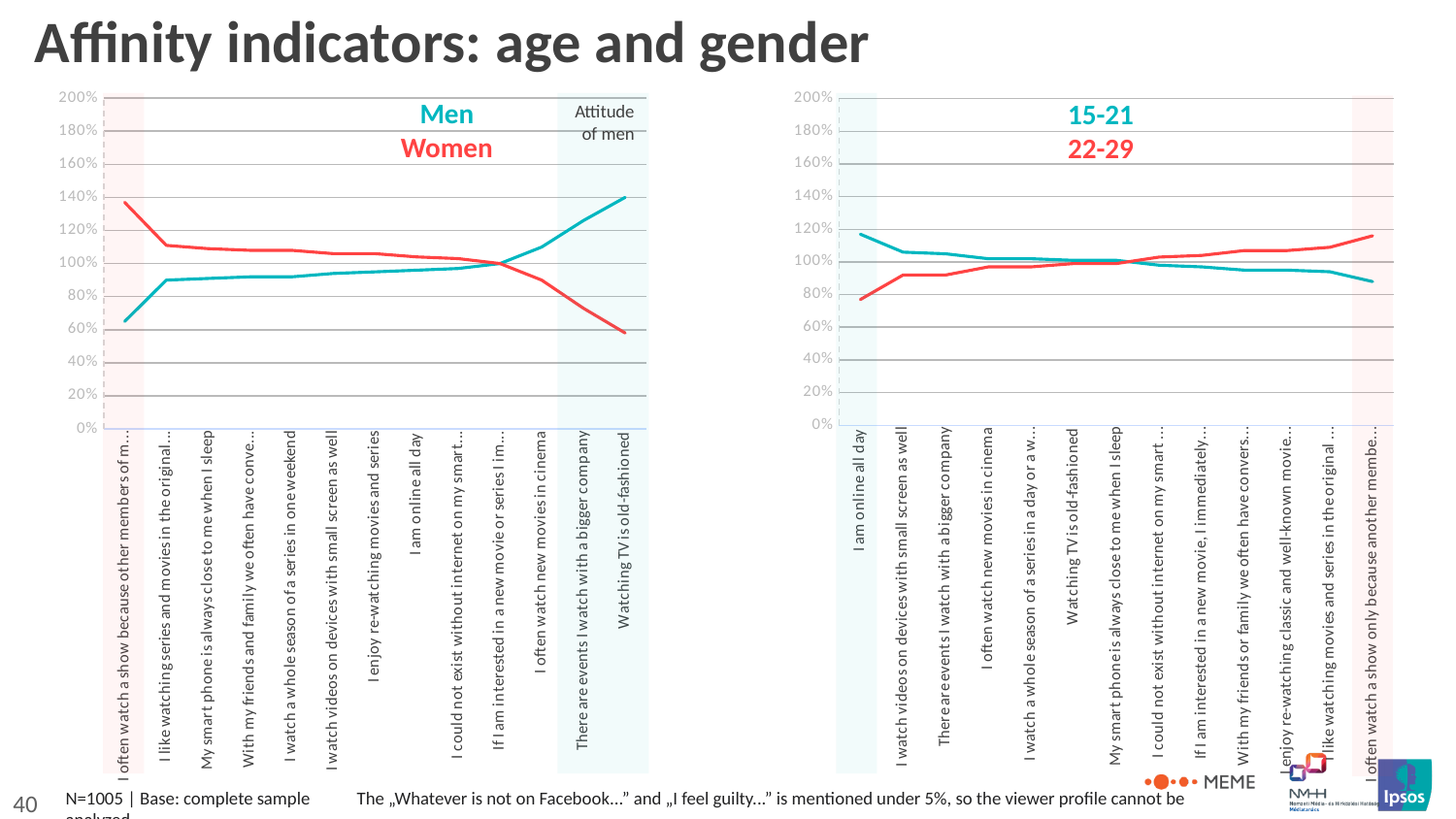
In the right chart, for "I often watch a show only because another membe...", which series is higher, 15-21 or 22-29? 22-29 How many series does the legend of the right chart list? 2 In the left chart, for "I often watch a show because other members of m...", which series is higher, Men or Women? Women In the left chart, is the Men value for "Watching TV is old-fashioned" greater or less than 120%? greater In the left chart, is the Women value for "Watching TV is old-fashioned" greater or less than 80%? less In the right chart, is the 15-21 value for "I am online all day" greater or less than 100%? greater How many statements are plotted along the x axis of the left chart? 13 In the right chart, does the 22-29 line generally rise or fall from left to right along the x axis? rise In the left chart, does the Men line generally rise or fall from left to right along the x axis? rise How many series does the legend of the left chart list? 2 What kind of chart is the left chart (Men / Women)? line chart In the left chart, for which statement is the Women line at its highest? I often watch a show because other members of m...